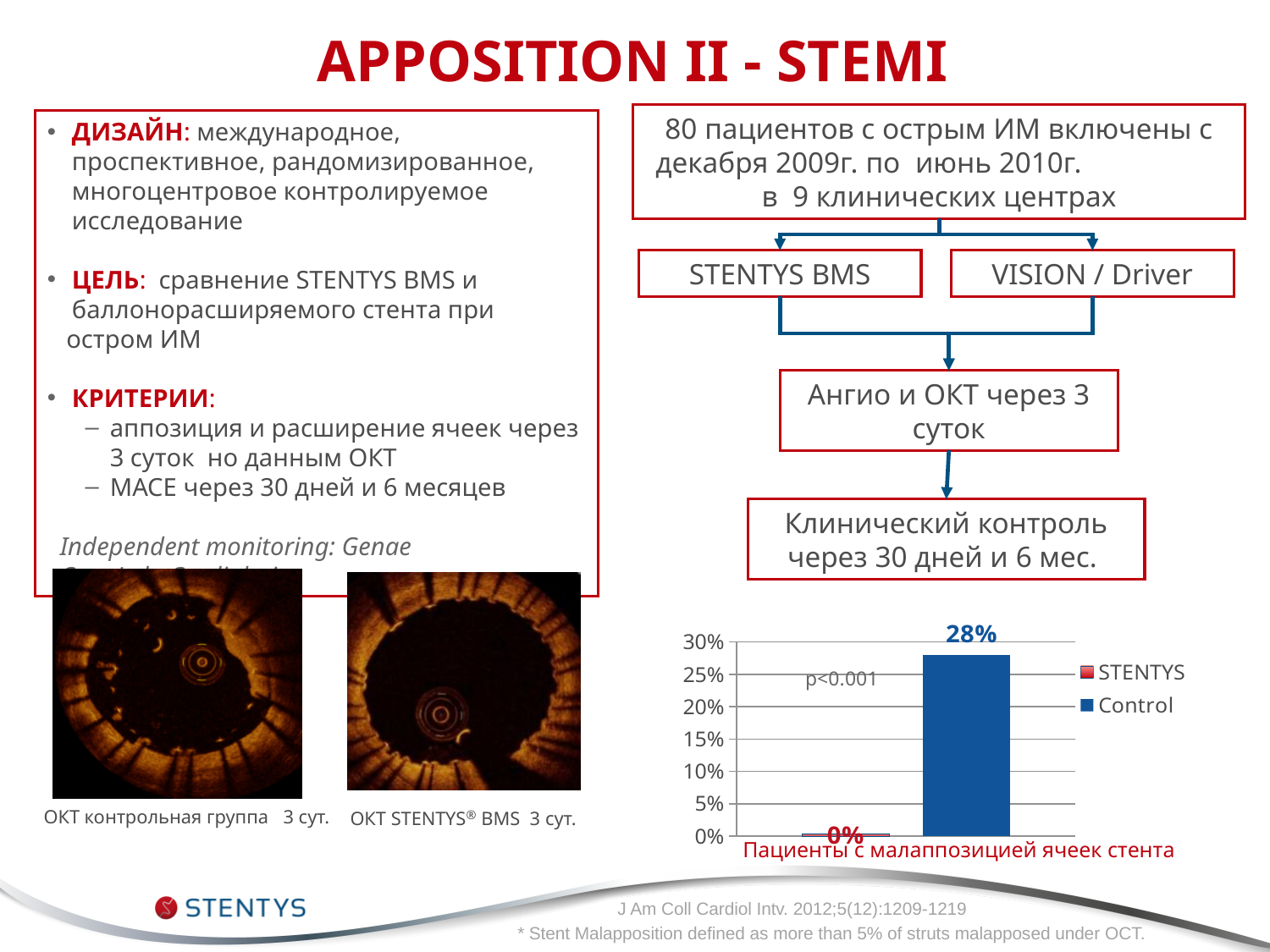
What is the difference between the Control and STENTYS values in the bar chart? 28% What type of chart is shown at the bottom right of the slide? bar chart In the bar chart, what is the value for Control? 28% Is the value for Control in the bar chart greater or less than 25%? greater In the bar chart, what is the value for STENTYS? 0% Which series in the bar chart has the highest value? Control Which series in the bar chart has the higher value, STENTYS or Control? Control What is the highest tick value shown on the y axis of the bar chart? 30% What p-value is annotated on the bar chart? p<0.001 Which series in the bar chart has the lowest value? STENTYS How many categories are shown on the x axis of the bar chart? 1 How many series does the legend of the bar chart list? 2